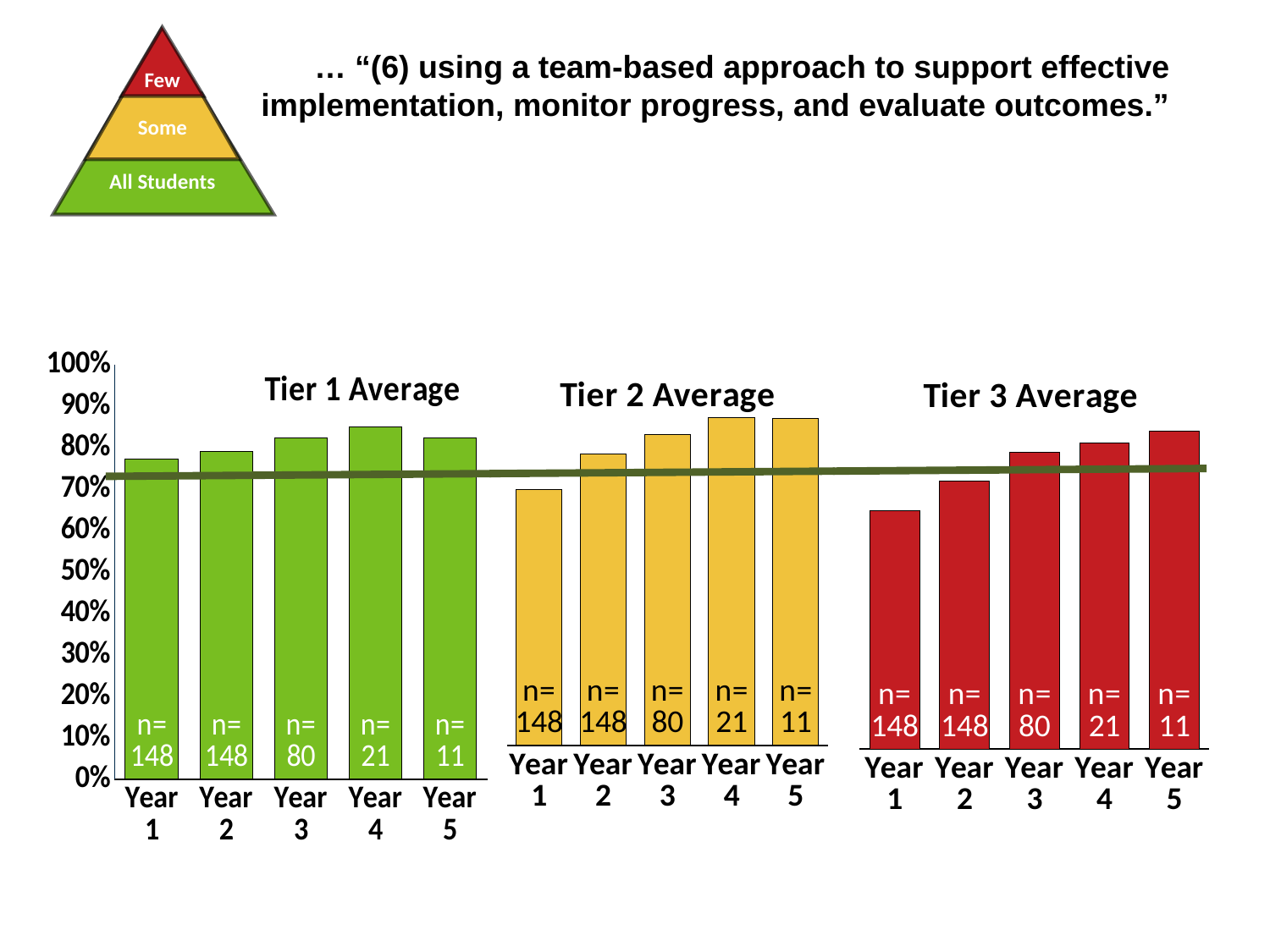
In the Tier 3 Average chart, do the values rise or fall from Year 1 to Year 5? rise In the Tier 2 Average chart, which year has the lowest value? Year 1 How many bars does the Tier 3 Average chart have? 5 In the Tier 3 Average chart, which is larger, the value for Year 1 or the value for Year 5? Year 5 In the Tier 1 Average chart, which year has the highest value? Year 4 In the Tier 1 Average chart, is the value for Year 4 greater or less than 80%? greater In the Tier 2 Average chart, what is the n shown on the Year 3 bar? 80 In the Tier 3 Average chart, which year has the lowest value? Year 1 In the Tier 3 Average chart, is the value for Year 1 greater or less than 70%? less In the Tier 3 Average chart, which year has the highest value? Year 5 What kind of chart is used for the Tier 1 Average? bar chart